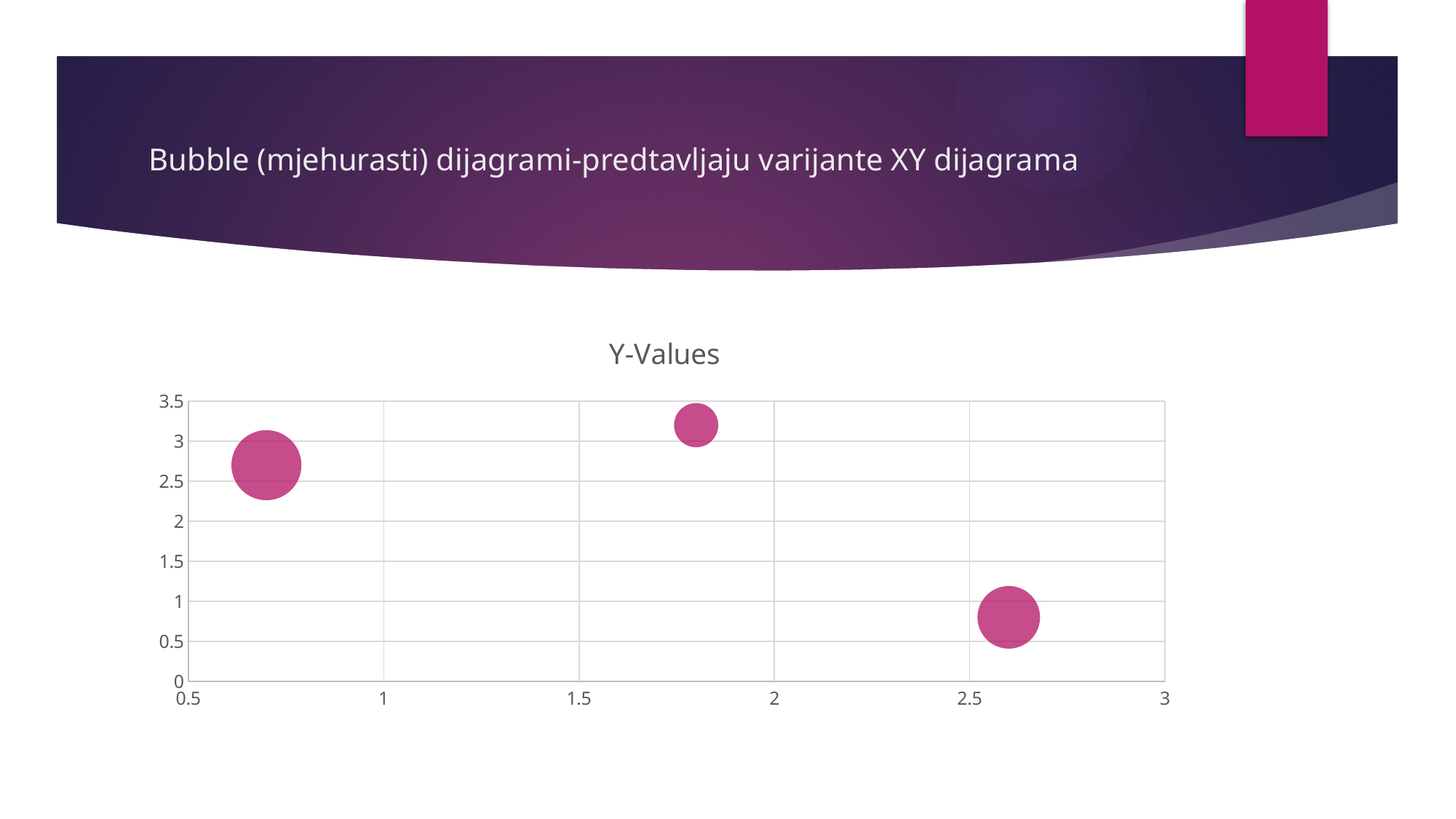
Is the y value of the rightmost bubble greater or less than 1.5? less Is the x value of the rightmost bubble greater or less than 2? greater Which has the larger y value, the leftmost bubble or the rightmost bubble? the leftmost bubble Is the y value of the leftmost bubble greater or less than 2? greater What is the title of the chart? Y-Values What is the highest value shown on the y axis? 3.5 Which bubble has the highest y value? the middle bubble (near x = 1.8) How many bubbles are plotted on the chart? 3 Which bubble has the lowest y value? the rightmost bubble (near x = 2.6) What kind of chart is shown on the slide? bubble chart